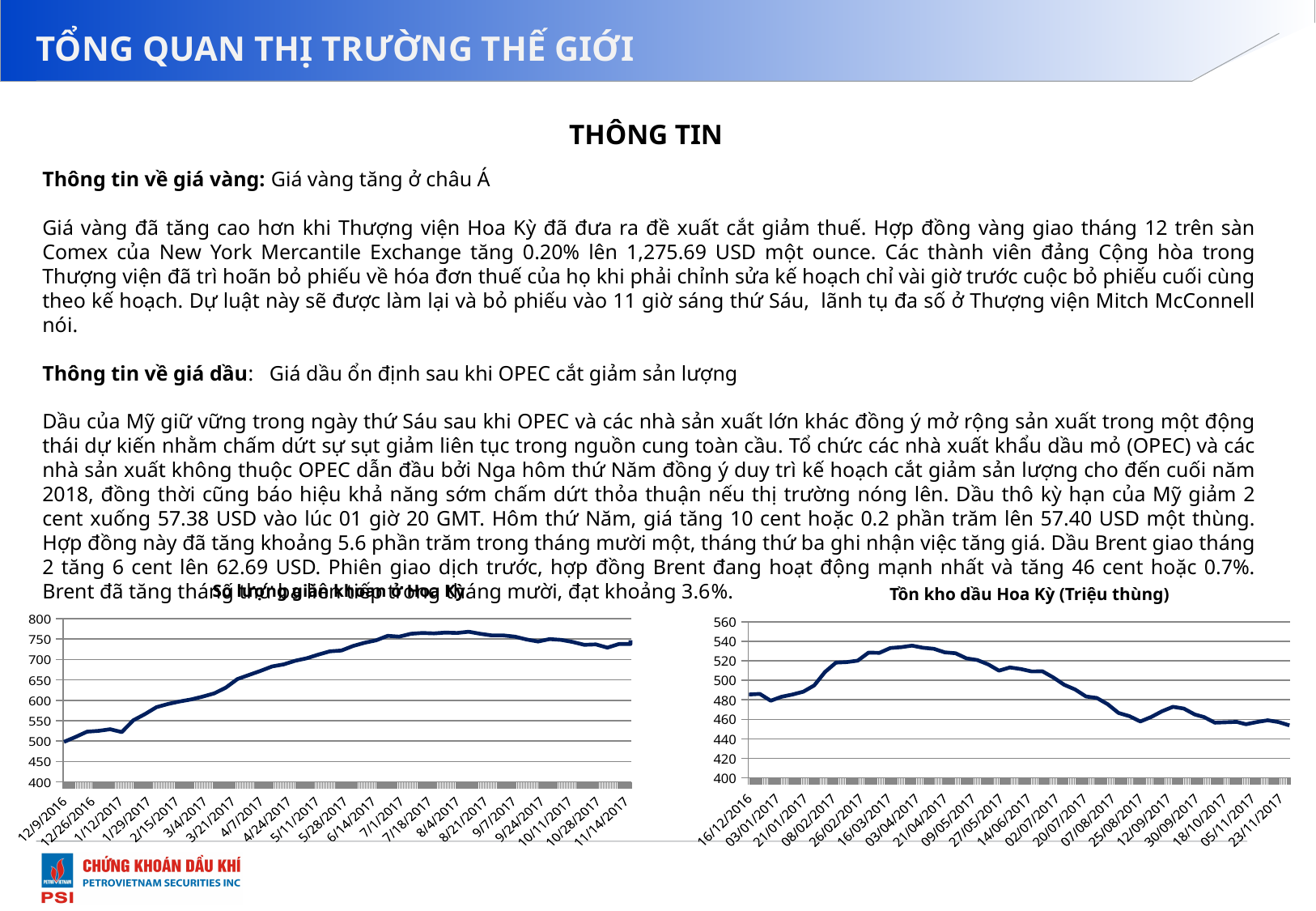
What kind of chart is the chart on the left side of the slide? line chart In the chart titled 'Tồn kho dầu Hoa Kỳ (Triệu thùng)', is the value for 16/12/2016 greater or less than 500? less What kind of chart is the chart titled 'Tồn kho dầu Hoa Kỳ (Triệu thùng)'? line chart In the chart titled 'Tồn kho dầu Hoa Kỳ (Triệu thùng)', which is larger, the value for 16/12/2016 or the value for 23/11/2017? 16/12/2016 In the chart titled 'Tồn kho dầu Hoa Kỳ (Triệu thùng)', is the value for 23/11/2017 greater or less than 480? less In the chart on the left side of the slide, do the values generally rise or fall from 12/9/2016 to 8/4/2017? rise In the chart titled 'Tồn kho dầu Hoa Kỳ (Triệu thùng)', do the values generally rise or fall from 03/04/2017 to 23/11/2017? fall What is the title of the chart on the right side of the slide? Tồn kho dầu Hoa Kỳ (Triệu thùng) In the chart on the left side of the slide, is the value for 8/4/2017 greater or less than 700? greater In the chart on the left side of the slide, which is larger, the value for 12/9/2016 or the value for 11/14/2017? 11/14/2017